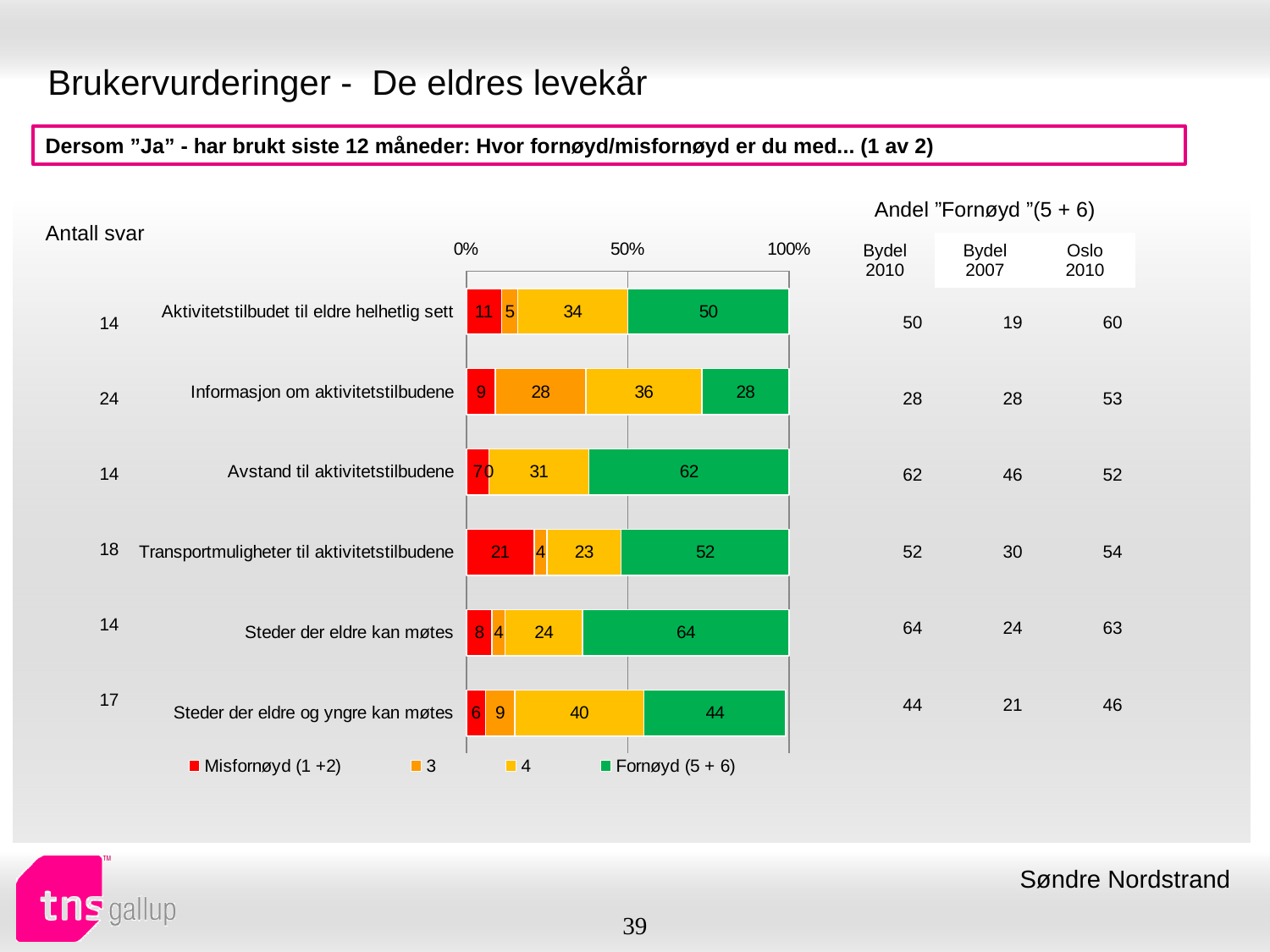
What kind of chart is shown on the slide? Stacked bar chart Which category has the highest value for the "Misfornøyd (1 +2)" series? Transportmuligheter til aktivitetstilbudene What is the value of the "Misfornøyd (1 +2)" series for "Transportmuligheter til aktivitetstilbudene"? 21 How many categories are shown in the chart? 6 What is the value of the "4" series for "Steder der eldre og yngre kan møtes"? 40 Which category has the lowest value for the "Fornøyd (5 + 6)" series? Informasjon om aktivitetstilbudene What is the difference between the "Fornøyd (5 + 6)" values for "Steder der eldre kan møtes" and "Steder der eldre og yngre kan møtes"? 20 Which has a larger "Fornøyd (5 + 6)" value: "Avstand til aktivitetstilbudene" or "Aktivitetstilbudet til eldre helhetlig sett"? Avstand til aktivitetstilbudene Which category has the highest value for the "Fornøyd (5 + 6)" series? Steder der eldre kan møtes What is the value of the "3" series for "Informasjon om aktivitetstilbudene"? 28 How many series does the legend list? 4 What is the value of the "Fornøyd (5 + 6)" series for "Aktivitetstilbudet til eldre helhetlig sett"? 50